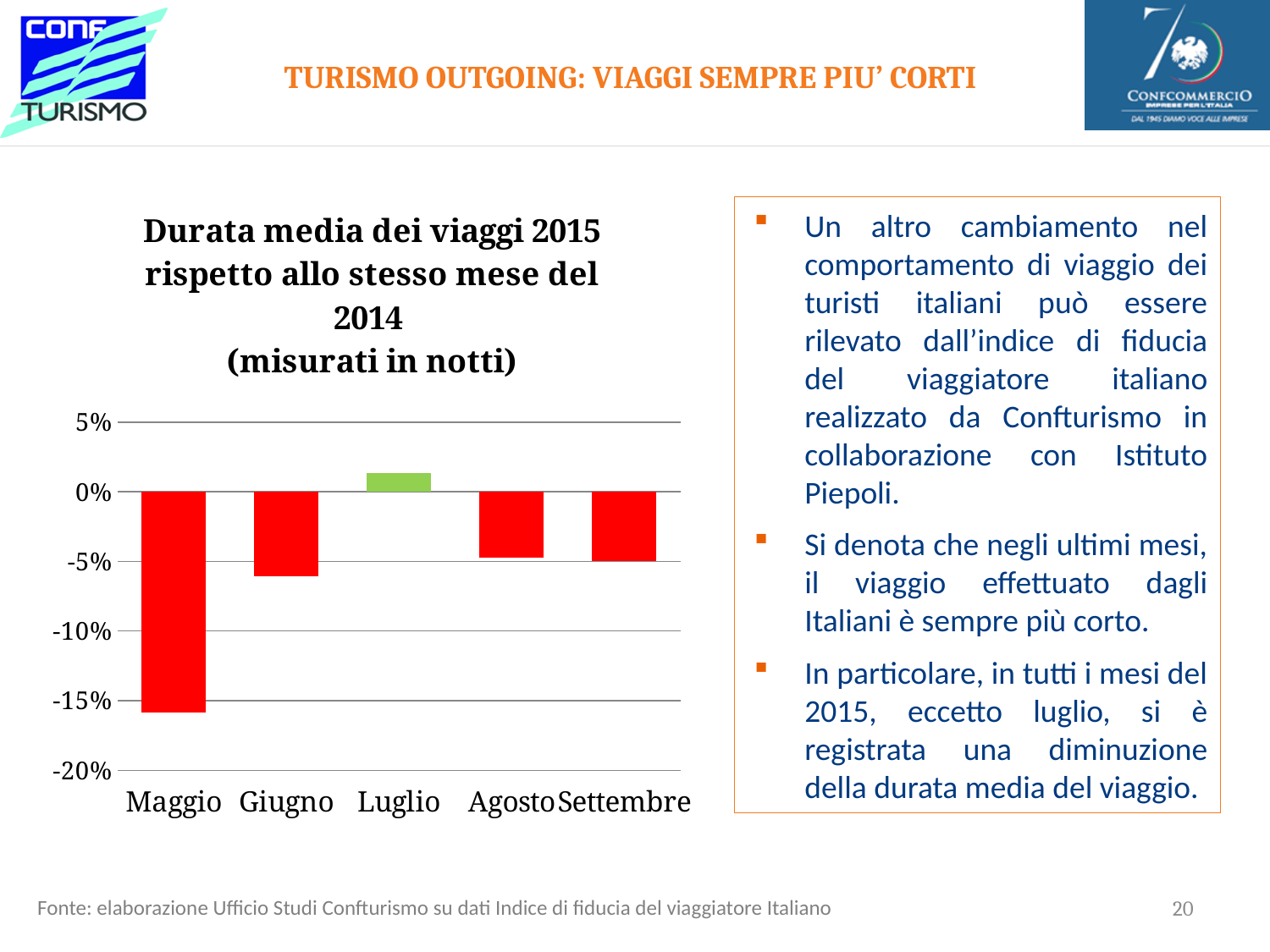
Which is larger, the value for Luglio or the value for Agosto? Luglio What is the title of the chart? Durata media dei viaggi 2015 rispetto allo stesso mese del 2014 (misurati in notti) Which is larger, the value for Maggio or the value for Giugno? Giugno Is the value for Luglio greater or less than 0%? greater How many months are shown on the x axis of the chart? 5 Which month has the lowest value in the chart? Maggio Is the value for Giugno greater or less than -10%? greater Is the value for Maggio greater or less than -10%? less Which month has the highest value in the chart? Luglio What kind of chart is shown on the slide? bar chart